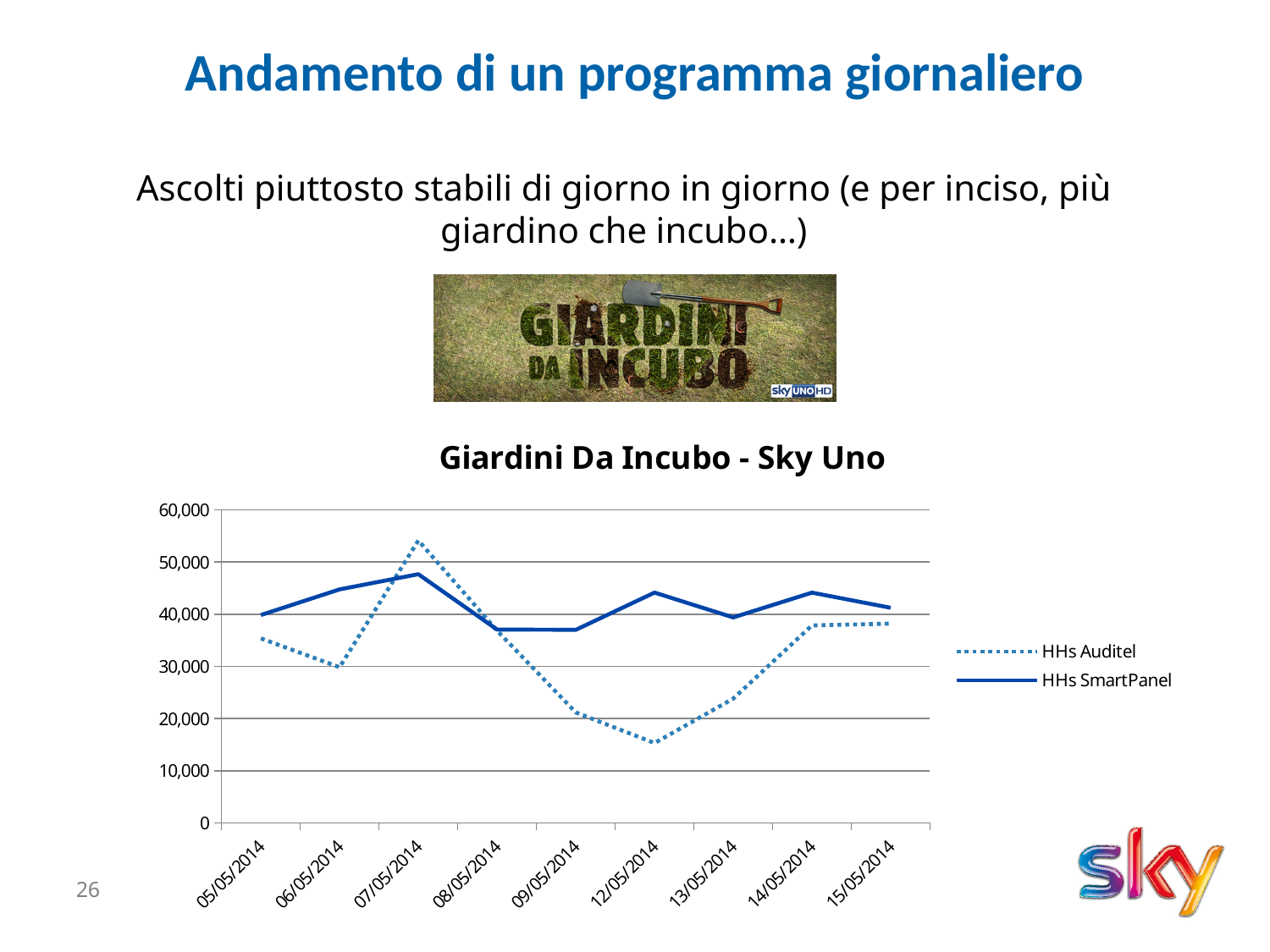
Which series is drawn with a dotted line? HHs Auditel How many series does the legend list? 2 How many dates are plotted along the x axis? 9 On 12/05/2014, which series has the higher value, HHs Auditel or HHs SmartPanel? HHs SmartPanel Is the HHs Auditel value for 07/05/2014 greater or less than 50,000? greater What kind of chart is shown on the slide? line chart What is the title of the chart? Giardini Da Incubo - Sky Uno Is the HHs SmartPanel value for 09/05/2014 greater or less than 30,000? greater On which date does the HHs SmartPanel series reach its highest value? 07/05/2014 On which date does the HHs Auditel series reach its highest value? 07/05/2014 Is the HHs Auditel value for 12/05/2014 greater or less than 20,000? less On which date does the HHs Auditel series reach its lowest value? 12/05/2014